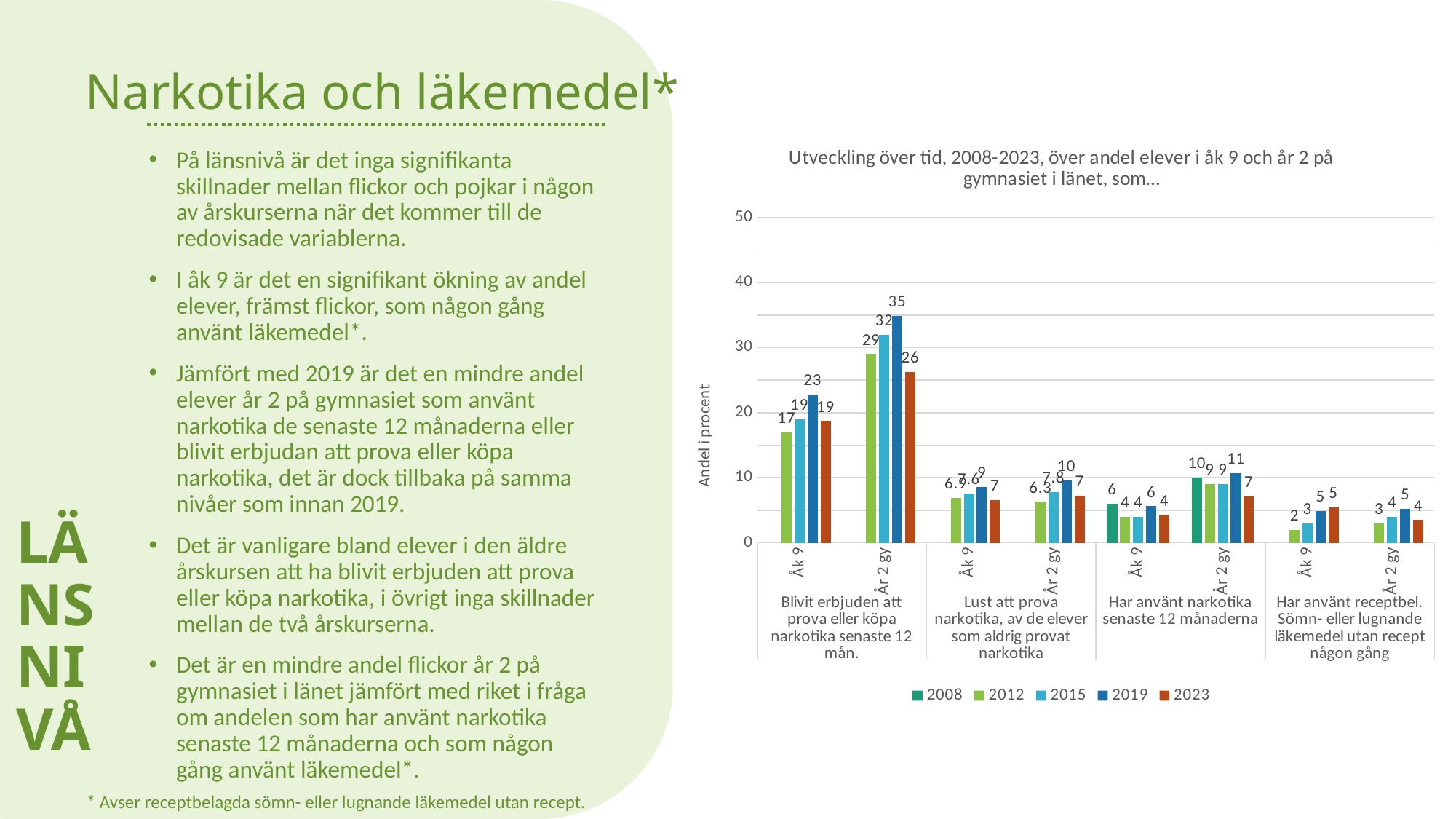
What is the 2019 value for Åk 9 in the 'Lust att prova narkotika, av de elever som aldrig provat narkotika' group? 9 For Åk 9 in the 'Blivit erbjuden att prova eller köpa narkotika senaste 12 mån.' group, which year has the larger value, 2019 or 2023? 2019 For Åk 9 in the 'Har använt receptbel. Sömn- eller lugnande läkemedel utan recept någon gång' group, what is the difference between the 2019 and 2012 values? 3 What is the label of the vertical axis? Andel i procent Which bar has the highest value in the whole chart? År 2 gy, 2019, Blivit erbjuden att prova eller köpa narkotika senaste 12 mån. (35) What is the 2023 value for Åk 9 in the 'Blivit erbjuden att prova eller köpa narkotika senaste 12 mån.' group? 19 What is the 2008 value for År 2 gy in the 'Har använt narkotika senaste 12 månaderna' group? 10 Is the 2019 value for År 2 gy in the 'Blivit erbjuden att prova eller köpa narkotika senaste 12 mån.' group greater or less than 30? greater What kind of chart is shown on the slide? Bar chart What is the 2019 value for År 2 gy in the 'Blivit erbjuden att prova eller köpa narkotika senaste 12 mån.' group? 35 How many series does the legend list? 5 In the 'Blivit erbjuden att prova eller köpa narkotika senaste 12 mån.' group, what is the difference between the 2019 and 2023 values for År 2 gy? 9